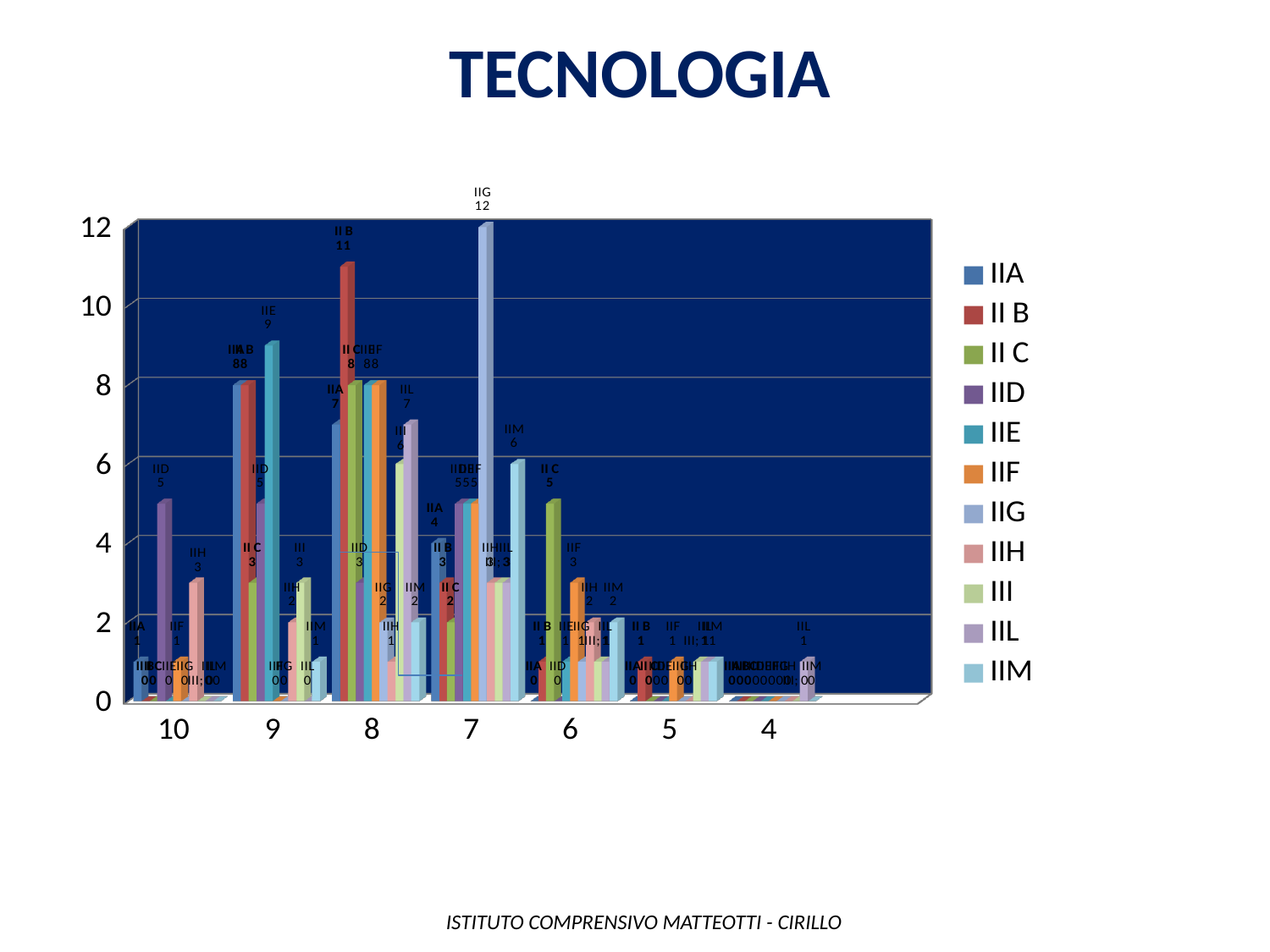
What kind of chart is shown on the slide? bar chart What is the value for IIE in category 9? 9 What is the value for IIL in category 4? 1 What is the difference between IIG in category 7 and II B in category 8? 1 What is the value for IIG in category 7? 12 What is the value for II B in category 8? 11 Which series has the tallest bar in the whole chart? IIG How many categories are shown on the x axis? 7 What is the title of the chart? TECNOLOGIA How many series does the legend list? 11 Which is larger: IIG in category 7 or II B in category 8? IIG in category 7 What is the value for IID in category 10? 5